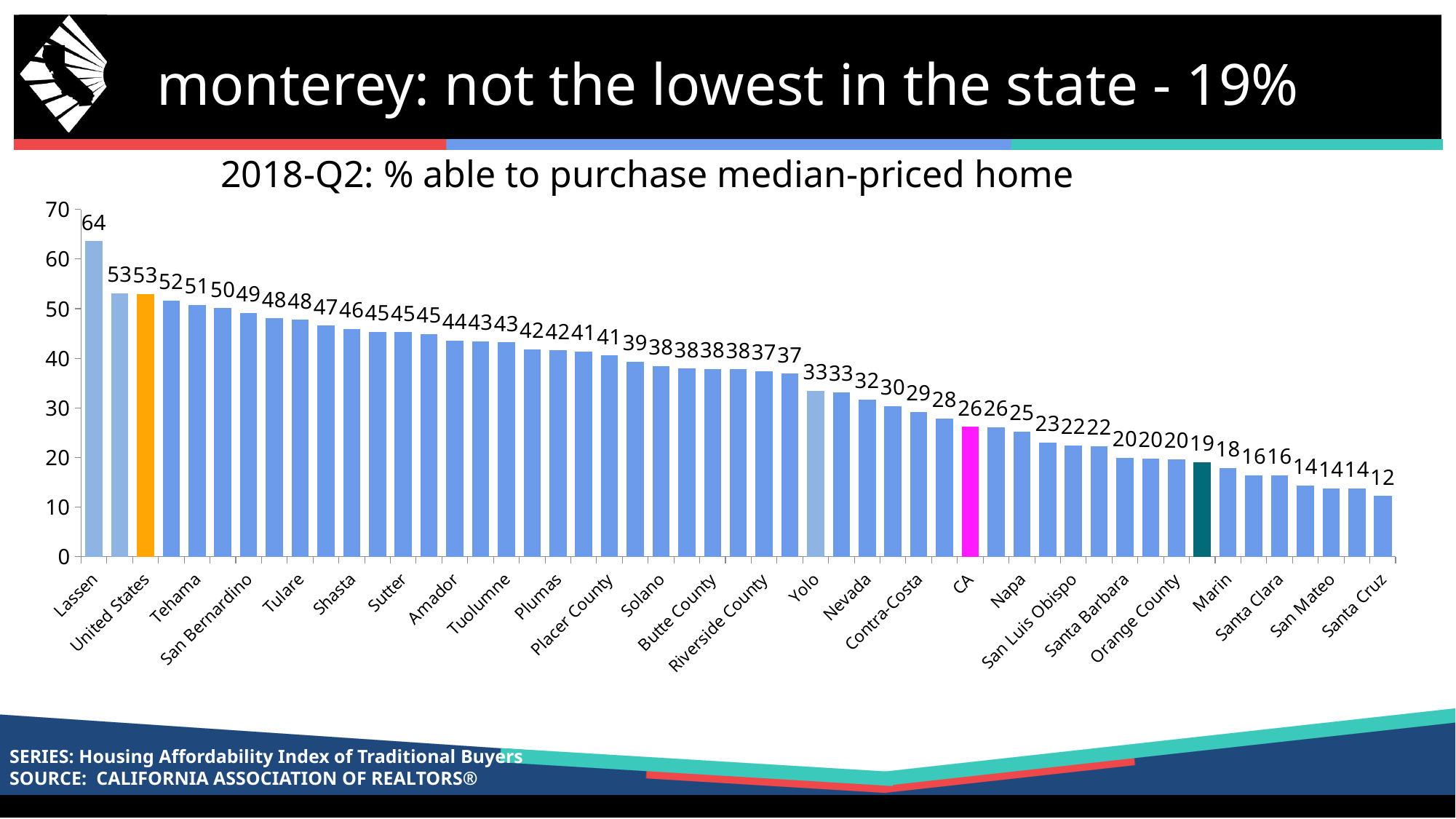
What is the difference between the values for Lassen and Santa Cruz? 52 Which category has the highest value? Lassen What is the value for Lassen? 64 What is the title of the chart? 2018-Q2: % able to purchase median-priced home Do the values rise or fall from left to right along the x axis? fall What is the value of the dark teal bar? 19 What is the value for Santa Cruz? 12 Which is larger, the value for United States or the value for CA? United States What kind of chart is shown on the slide? bar chart What is the value for CA? 26 Which category has the lowest value? Santa Cruz What is the value for United States? 53